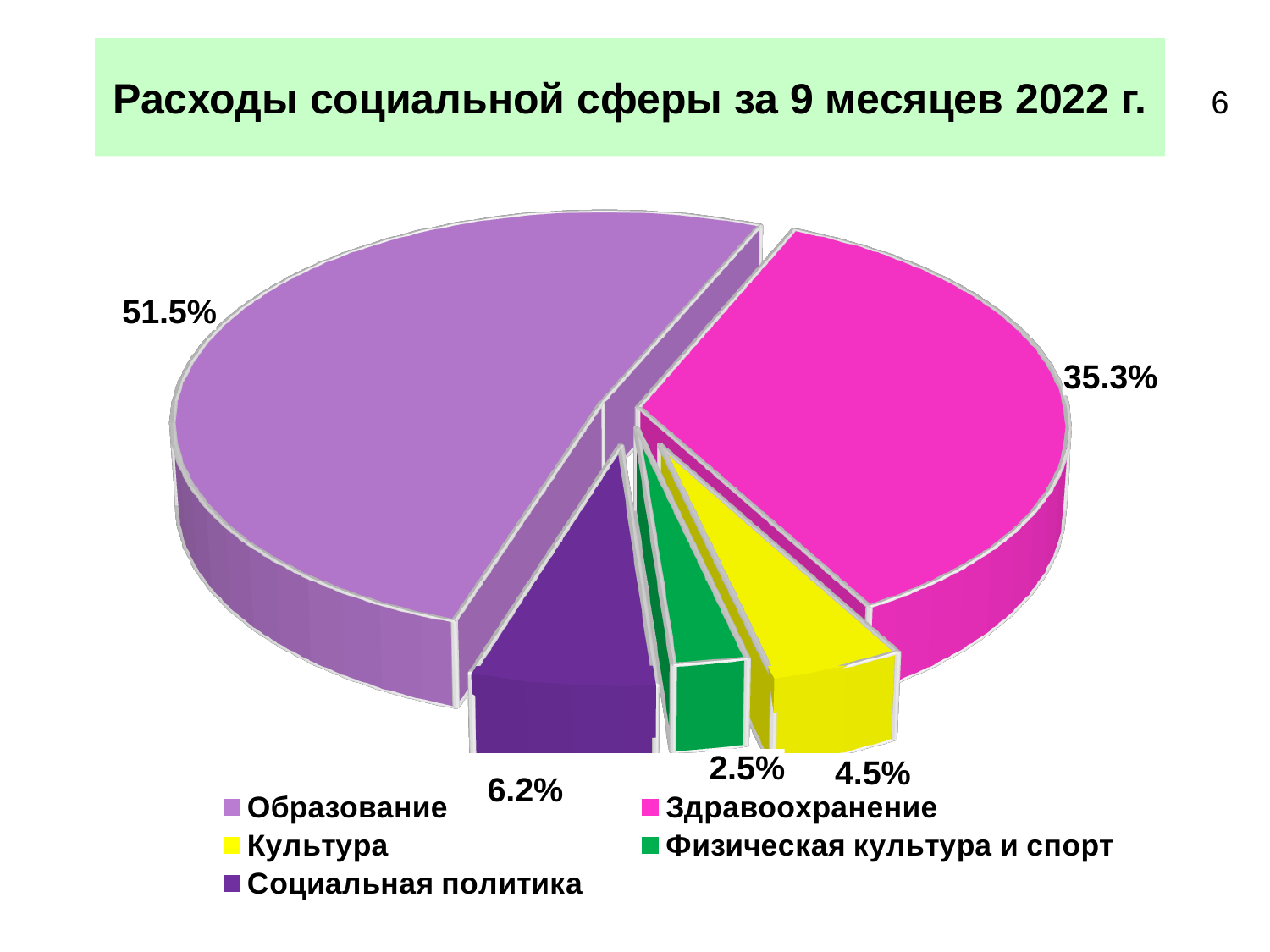
What is the share for Образование? 51.5% What is the share for Здравоохранение? 35.3% What type of chart is shown on the slide? pie chart What is the share for Физическая культура и спорт? 2.5% How many categories does the pie chart have? 5 What is the share for Культура? 4.5% Which category has the largest share of the pie? Образование What is the title of the chart on the slide? Расходы социальной сферы за 9 месяцев 2022 г. Which category has the smallest share of the pie? Физическая культура и спорт Which is larger, the share for Культура or the share for Социальная политика? Социальная политика What is the share for Социальная политика? 6.2% What is the difference between the shares of Образование and Здравоохранение? 16.2%